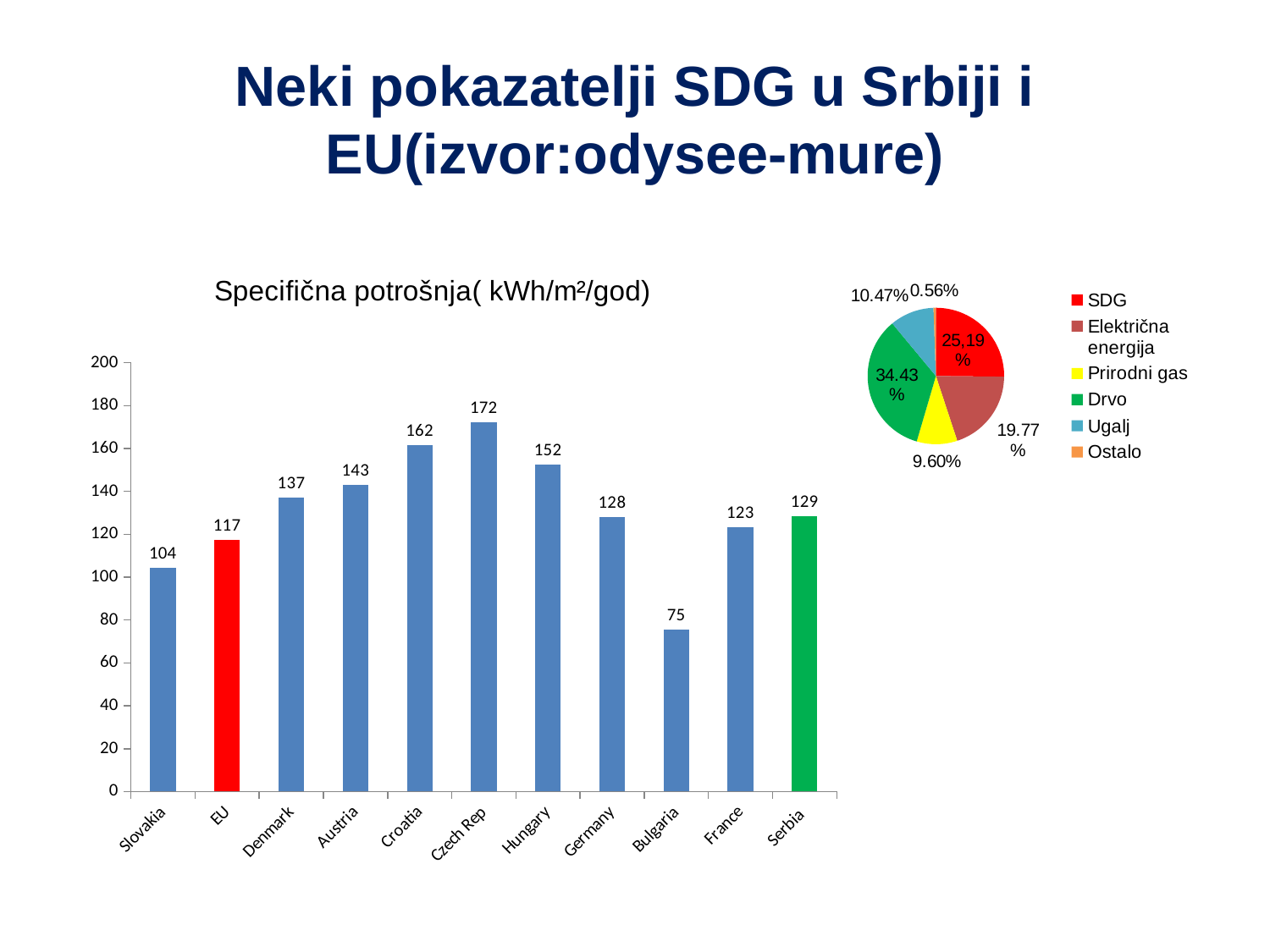
In the pie chart on the right, what share does SDG have? 25.19% In the bar chart 'Specifična potrošnja( kWh/m²/god)', which country has the highest value? Czech Rep In the pie chart on the right, what share does Drvo have? 34.43% In the bar chart 'Specifična potrošnja( kWh/m²/god)', which country has the lowest value? Bulgaria In the bar chart 'Specifična potrošnja( kWh/m²/god)', what is the difference between the values for Serbia and EU? 12 In the bar chart 'Specifična potrošnja( kWh/m²/god)', what is the value for EU? 117 How many categories are shown in the bar chart 'Specifična potrošnja( kWh/m²/god)'? 11 In the bar chart 'Specifična potrošnja( kWh/m²/god)', what is the value for Serbia? 129 In the bar chart 'Specifična potrošnja( kWh/m²/god)', which is larger, the value for Croatia or the value for Hungary? Croatia How many entries does the legend of the pie chart on the right list? 6 In the pie chart on the right, which category has the smallest share? Ostalo What kind of chart is 'Specifična potrošnja( kWh/m²/god)'? bar chart